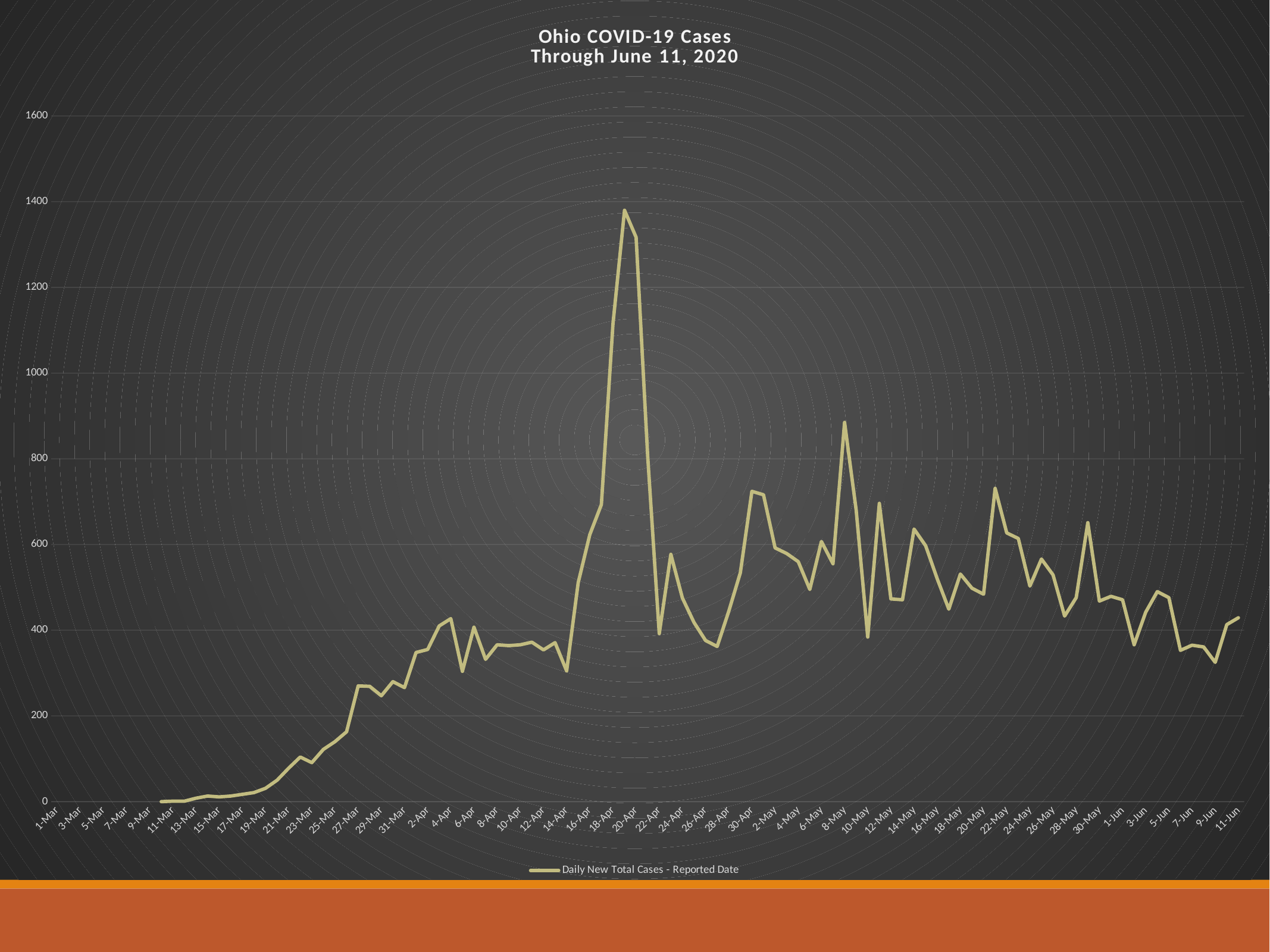
What series name is shown in the legend? Daily New Total Cases - Reported Date Is the value for 8-May greater or less than 800? greater Is the highest value on the line greater or less than 1200? greater What kind of chart is shown on the slide? line chart Is the value for 9-Jun greater or less than 400? less What is the highest value shown on the y axis? 1600 What is the title of the chart? Ohio COVID-19 Cases Through June 11, 2020 How many series does the legend list? 1 Do the values rise or fall between 9-Mar and 27-Mar? rise